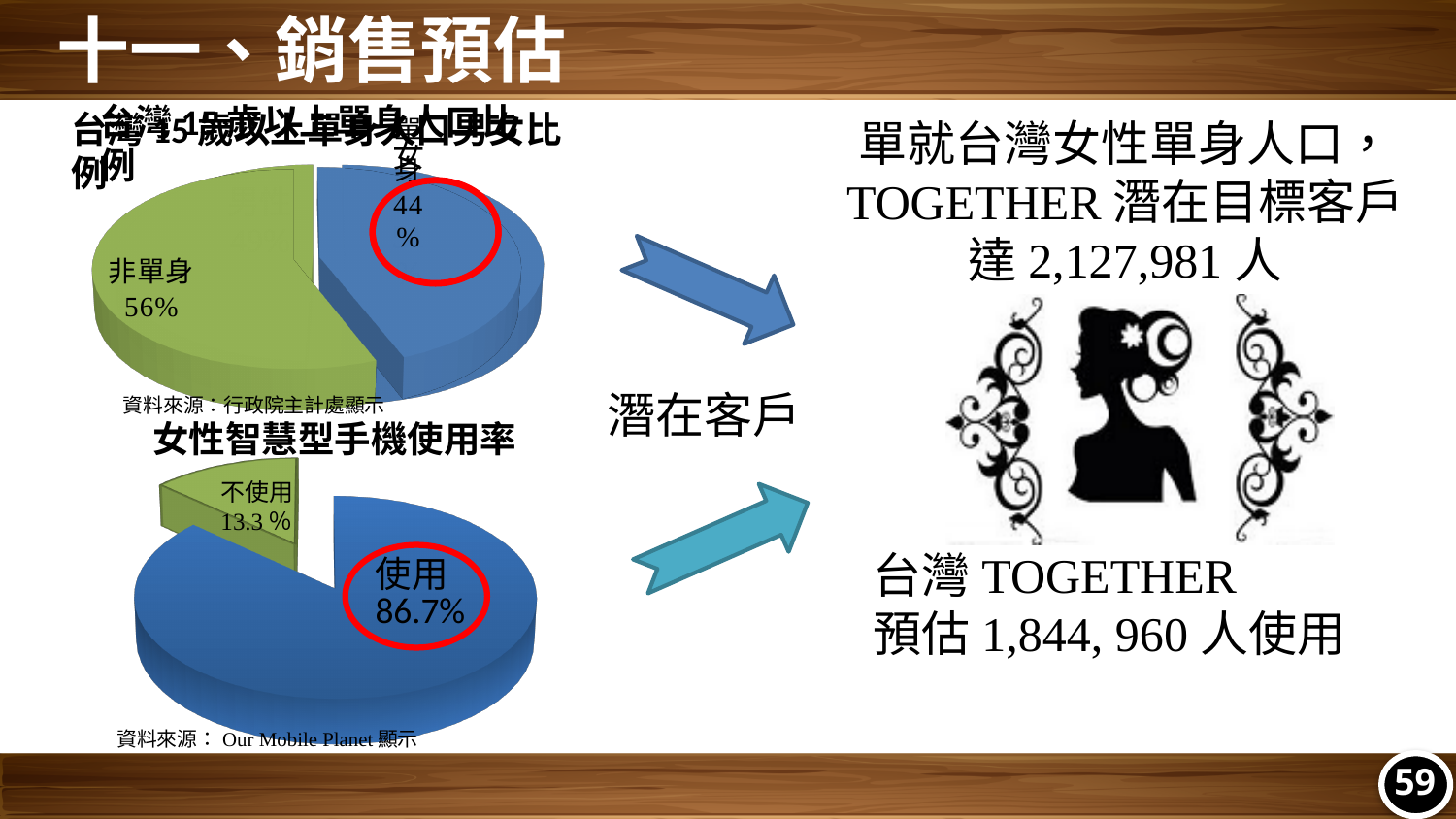
In the top pie chart, which slice is larger, 非單身 or 單身? 非單身 What type of chart is the top chart on the slide? pie chart In the chart titled 女性智慧型手機使用率, which slice is the largest? 使用 In the chart titled 女性智慧型手機使用率, what is the difference in percentage points between 使用 and 不使用? 73.4 How many slices does the top pie chart have? 2 In the top pie chart, what percentage is shown for 非單身? 56% In the chart titled 女性智慧型手機使用率, what percentage is shown for 使用? 86.7% In the top pie chart, what is the difference in percentage points between the 非單身 and 單身 slices? 12 In the top pie chart, what percentage is shown for the 單身 slice? 44% In the chart titled 女性智慧型手機使用率, what percentage is shown for 不使用? 13.3 % What type of chart is the chart titled 女性智慧型手機使用率? pie chart What is the title of the bottom chart on the slide? 女性智慧型手機使用率